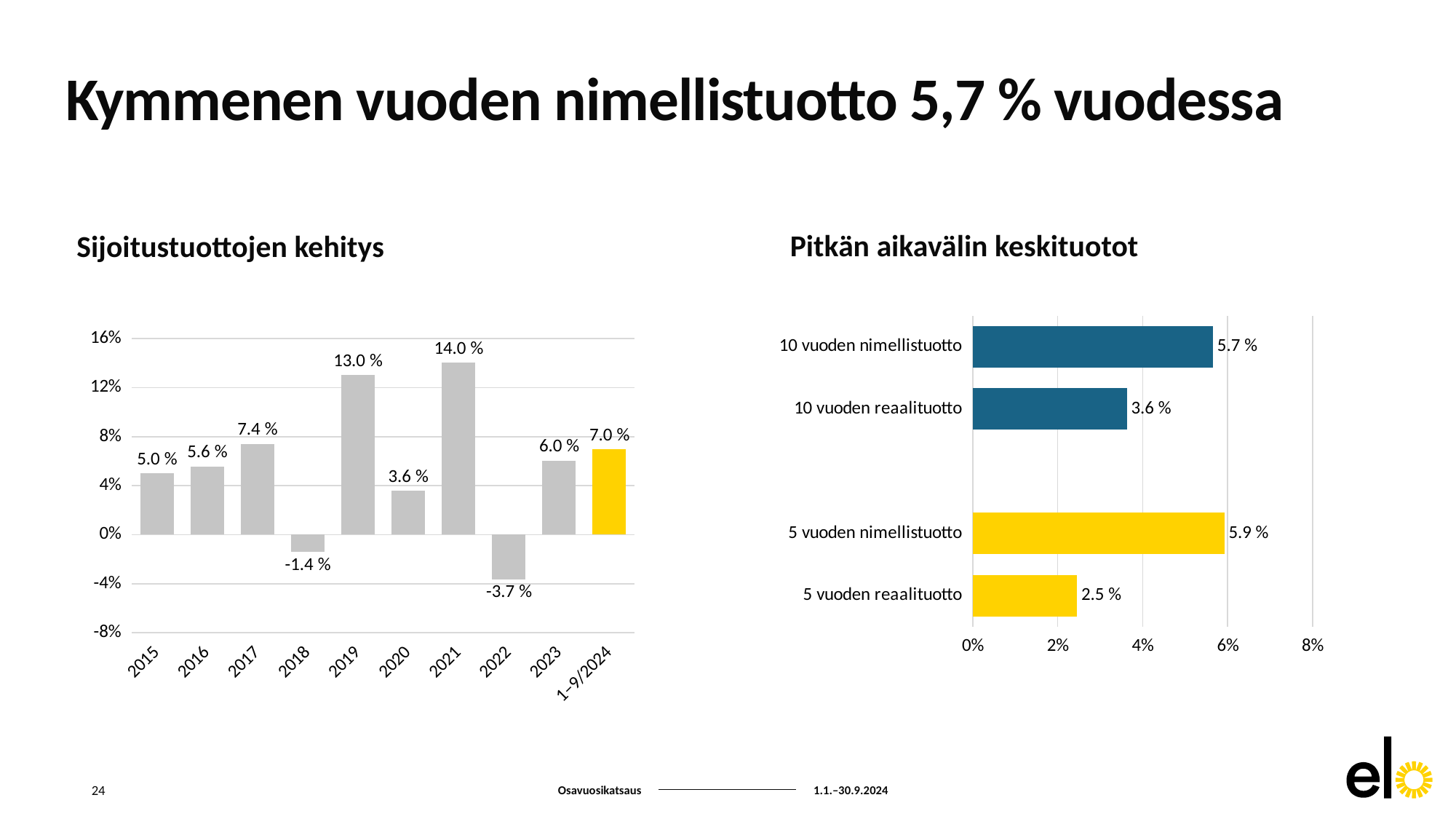
In the 'Pitkän aikavälin keskituotot' chart, which category has the lowest value? 5 vuoden reaalituotto What kind of chart is 'Pitkän aikavälin keskituotot'? Bar chart In the 'Sijoitustuottojen kehitys' chart, what is the value for 1–9/2024? 7.0 % In the 'Sijoitustuottojen kehitys' chart, which is larger, the value for 2017 or the value for 2023? 2017 In the 'Pitkän aikavälin keskituotot' chart, what colour are the bars for the 5-year returns? Yellow How many categories are shown on the x axis of the 'Sijoitustuottojen kehitys' chart? 10 In the 'Sijoitustuottojen kehitys' chart, which year has the highest value? 2021 In the 'Sijoitustuottojen kehitys' chart, what is the difference between the values for 2021 and 2020? 10.4 % In the 'Pitkän aikavälin keskituotot' chart, what is the value for '10 vuoden reaalituotto'? 3.6 % In the 'Sijoitustuottojen kehitys' chart, what is the value for 2019? 13.0 % In the 'Pitkän aikavälin keskituotot' chart, what is the difference between '5 vuoden nimellistuotto' and '5 vuoden reaalituotto'? 3.4 % In the 'Sijoitustuottojen kehitys' chart, which year has the lowest value? 2022